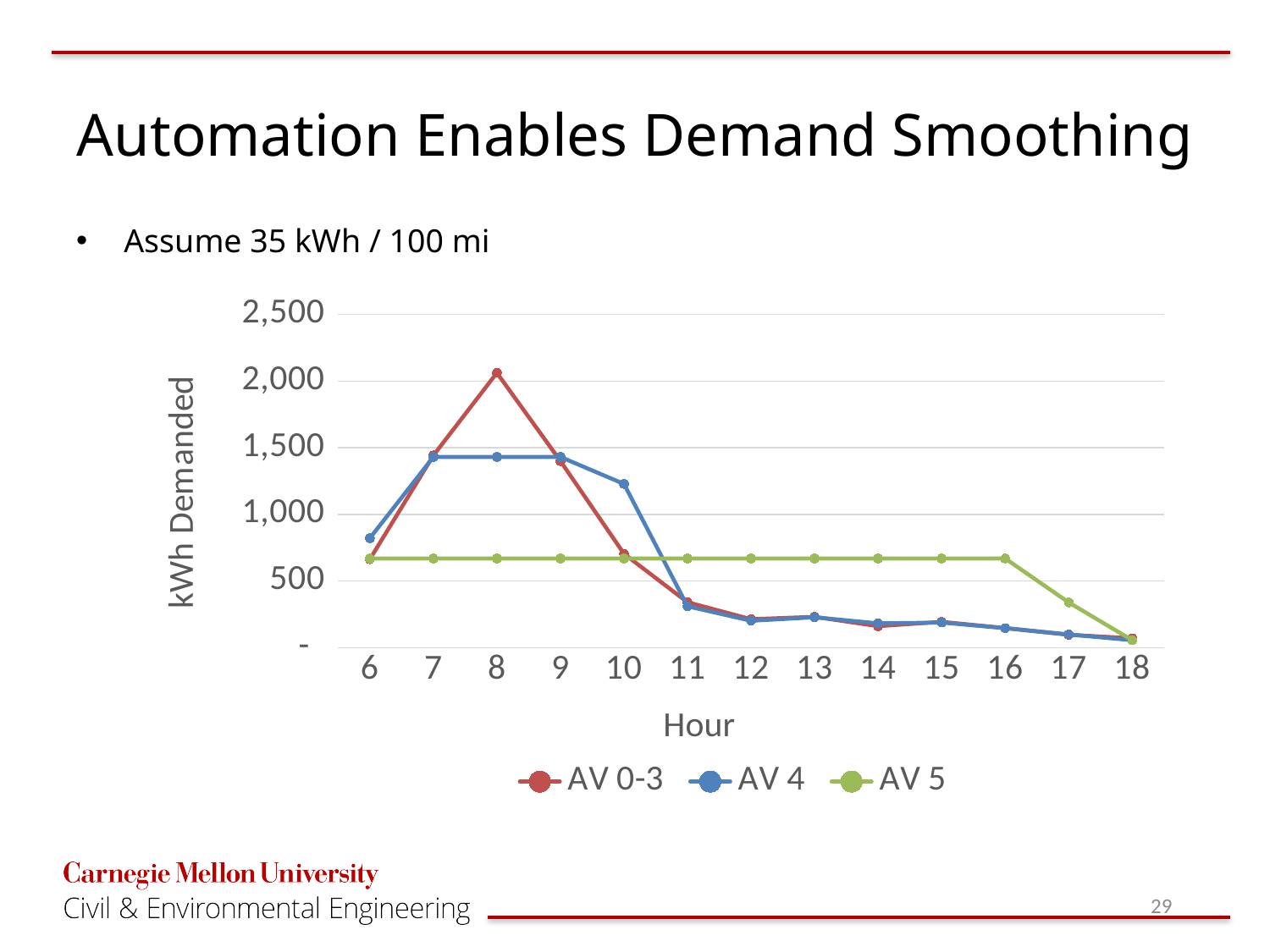
Is the value for AV 4 at hour 6 greater or less than 1,000? less Is the value for AV 5 at hour 10 greater or less than 1,000? less At hour 17, which series has the larger value, AV 5 or AV 4? AV 5 How many hours are plotted along the x axis? 13 What is the title of the y axis? kWh Demanded What kind of chart is shown on the slide? line chart Which series reaches the highest peak value on the chart? AV 0-3 At which hour does the AV 0-3 series reach its highest value? 8 Which series has the lowest value at hour 8? AV 5 How many series does the legend list? 3 At hour 10, which series has the larger value, AV 4 or AV 0-3? AV 4 Is the value for AV 0-3 at hour 8 greater or less than 1,500? greater